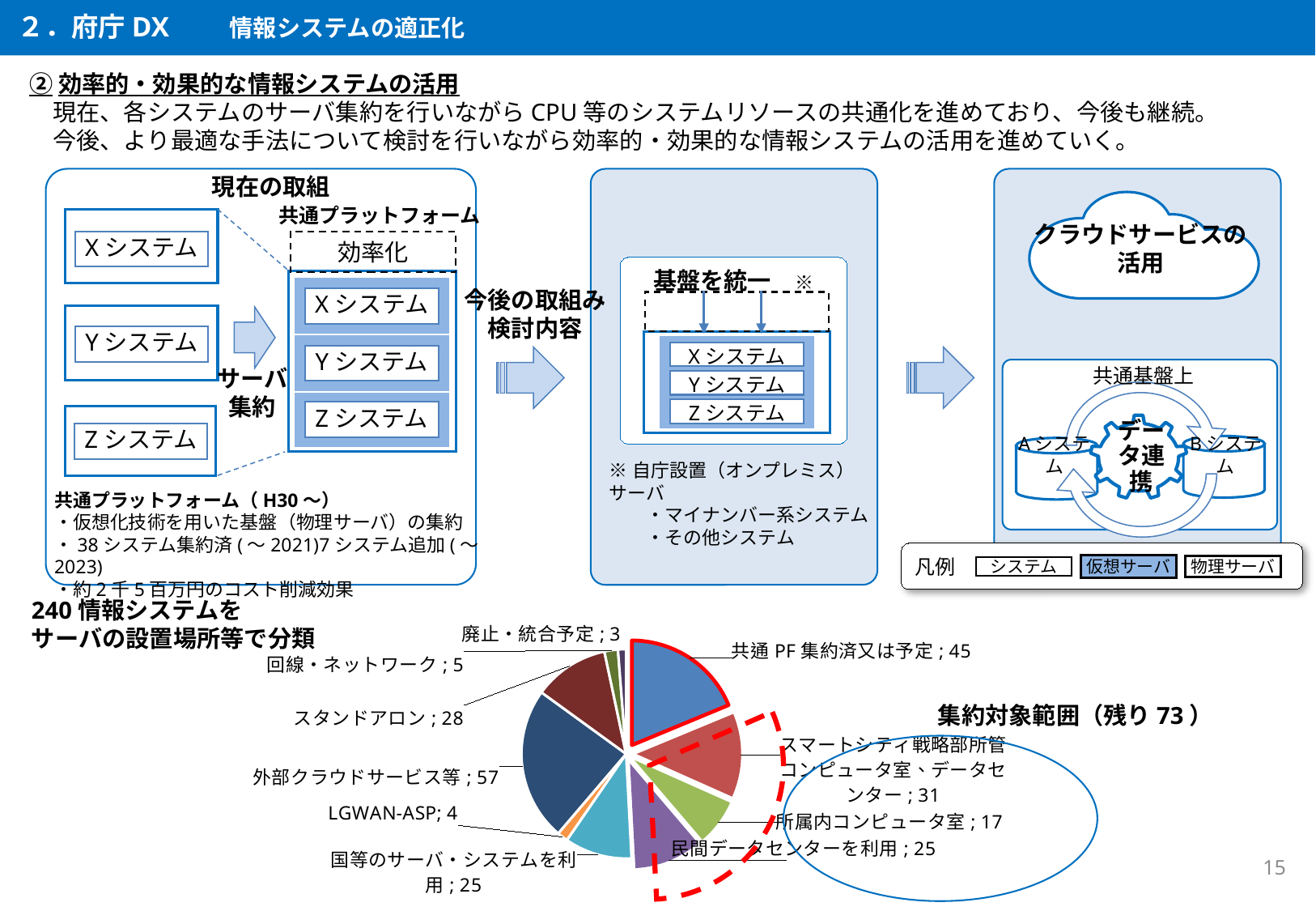
Which category has the largest slice in the pie chart? 外部クラウドサービス等 What is the value for スマートシティ戦略部所管コンピュータ室、データセンター in the pie chart? 31 What is the total of all slices in the pie chart? 240 What is the value for 共通PF集約済又は予定 in the pie chart? 45 What is the value for 外部クラウドサービス等 in the pie chart? 57 What is the difference between the values for 外部クラウドサービス等 and 共通PF集約済又は予定 in the pie chart? 12 Which is larger in the pie chart: スタンドアロン or 民間データセンターを利用? スタンドアロン Which category has the smallest slice in the pie chart? 廃止・統合予定 How many categories does the pie chart show? 10 What type of chart is shown at the bottom of the slide? pie chart What is the value for 所属内コンピュータ室 in the pie chart? 17 What share of the pie chart does 外部クラウドサービス等 represent? 23.75%